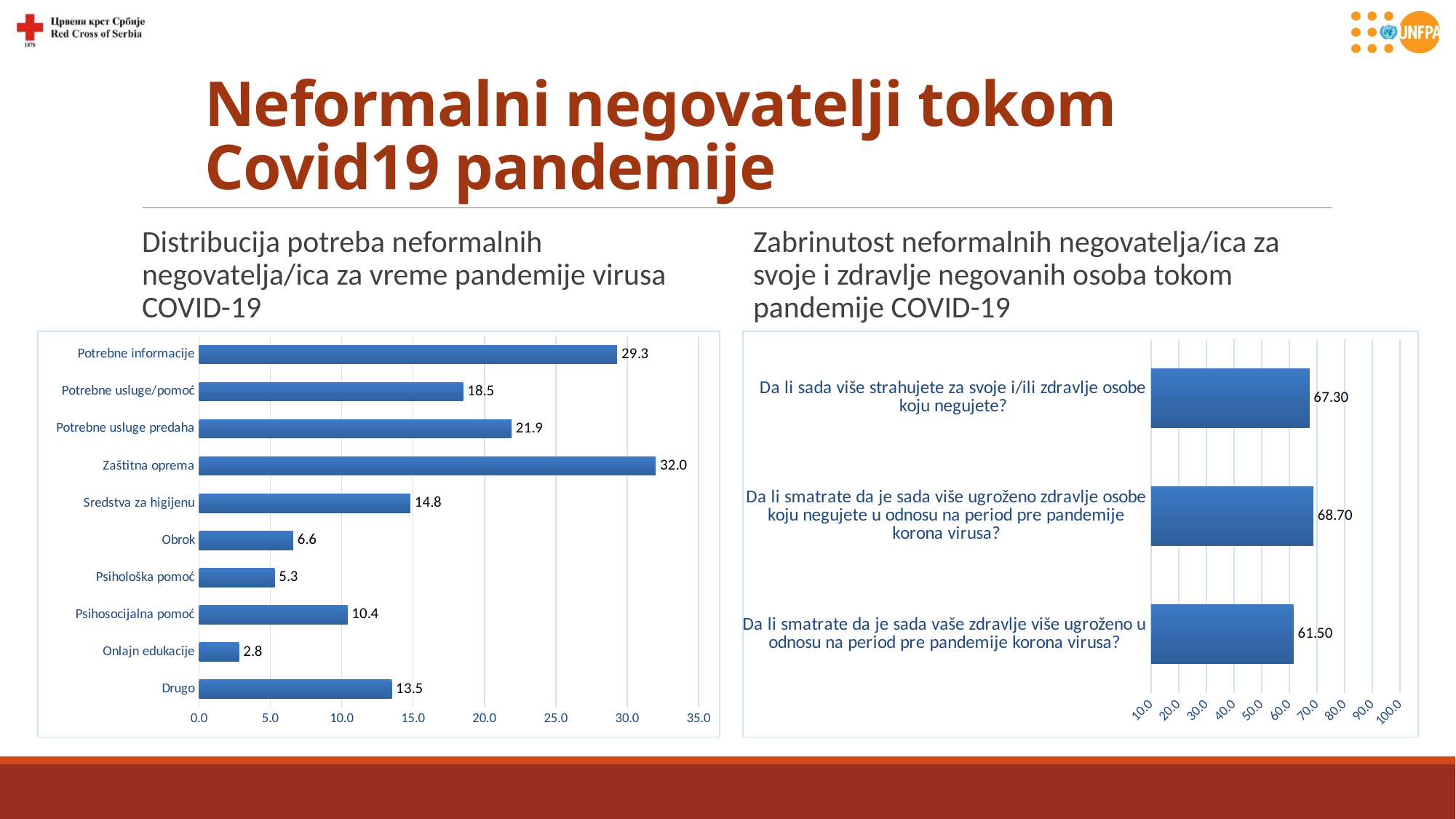
In the left chart (Distribucija potreba neformalnih negovatelja/ica), what is the value for Zaštitna oprema? 32.0 In the right chart (Zabrinutost neformalnih negovatelja/ica), what is the value for the question 'Da li sada više strahujete za svoje i/ili zdravlje osobe koju negujete?' 67.30 In the right chart (Zabrinutost neformalnih negovatelja/ica), how many bars are shown? 3 In the left chart (Distribucija potreba neformalnih negovatelja/ica), what is the difference between Potrebne informacije and Potrebne usluge/pomoć? 10.8 In the left chart (Distribucija potreba neformalnih negovatelja/ica), which is larger: Sredstva za higijenu or Drugo? Sredstva za higijenu In the right chart (Zabrinutost neformalnih negovatelja/ica), what is the difference between the highest and lowest values? 7.20 In the left chart (Distribucija potreba neformalnih negovatelja/ica), how many categories are shown? 10 In the right chart (Zabrinutost neformalnih negovatelja/ica), which question has the highest value? Da li smatrate da je sada više ugroženo zdravlje osobe koju negujete u odnosu na period pre pandemije korona virusa? In the left chart (Distribucija potreba neformalnih negovatelja/ica), which category has the highest value? Zaštitna oprema In the left chart (Distribucija potreba neformalnih negovatelja/ica), what is the value for Psihosocijalna pomoć? 10.4 In the left chart (Distribucija potreba neformalnih negovatelja/ica), which category has the lowest value? Onlajn edukacije What kind of chart is the left chart (Distribucija potreba neformalnih negovatelja/ica)? Bar chart